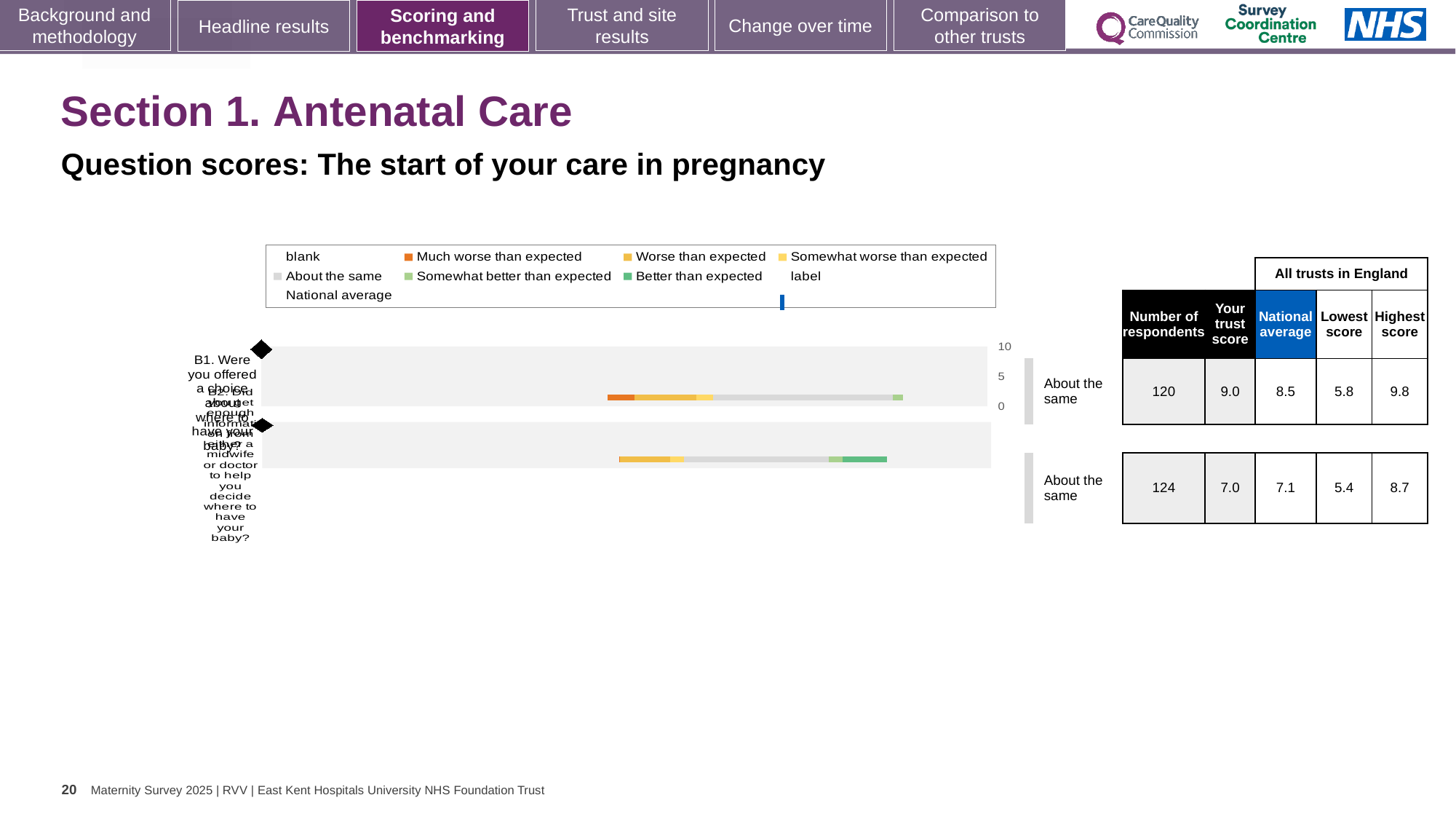
How many respondents answered question B1? 120 By how much does the trust score for B1 exceed the national average for B1? 0.5 Which is larger for question B2: the trust score or the national average? national average What is the 'Your trust score' for question B1 (Were you offered a choice about where to have your baby?)? 9.0 What is the lowest score among all trusts in England for question B2? 5.4 What kind of chart is shown on the slide? bar chart Which colour does the legend use for 'Much worse than expected'? orange What is the national average score for question B2? 7.1 What is the highest value shown on the chart's score axis? 10 Is the trust score for question B1 greater or less than 5? greater How many questions (bars) are plotted in the chart? 2 What is the highest score among all trusts in England for question B1? 9.8